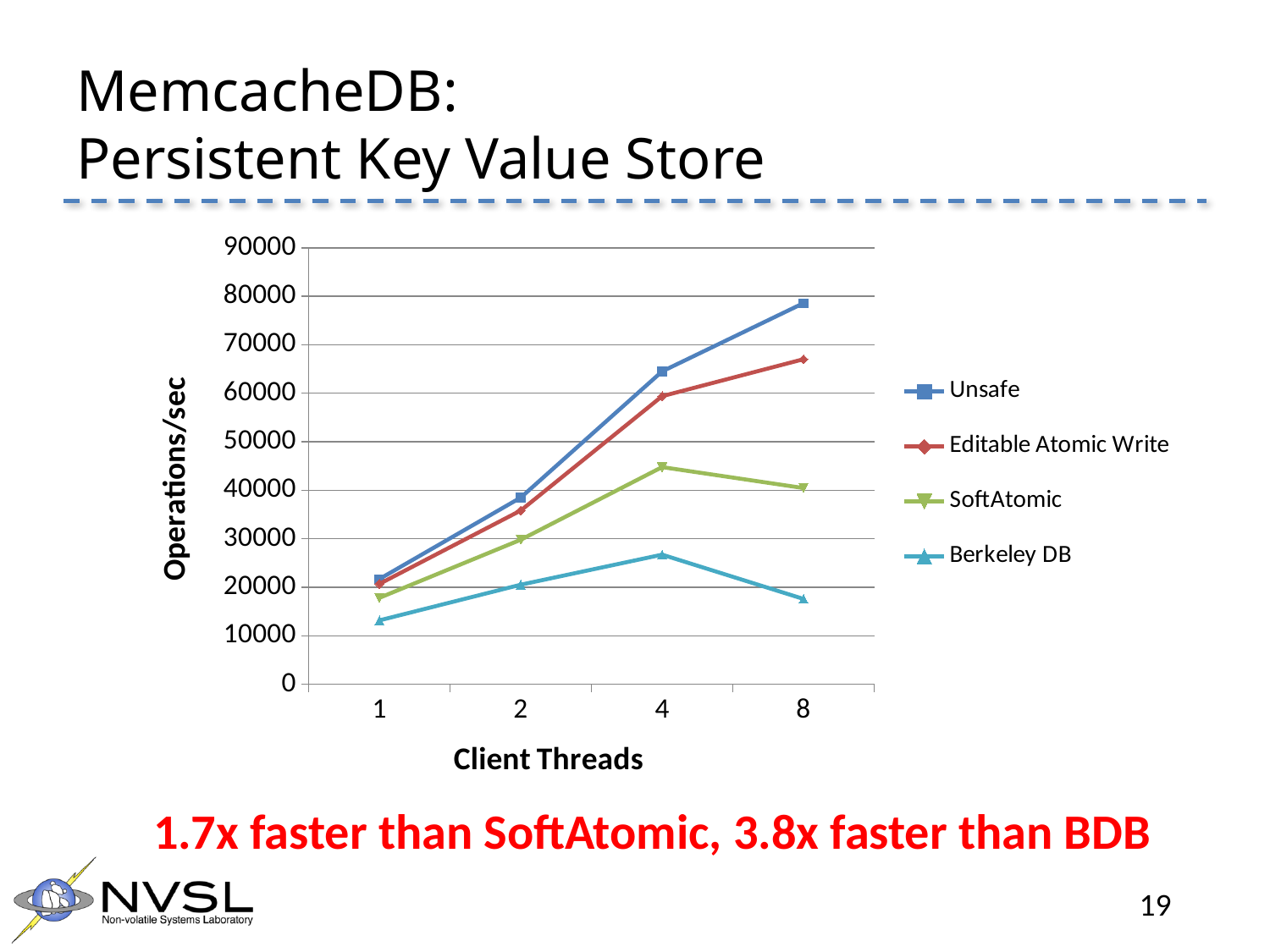
Is the value for SoftAtomic at 4 client threads greater or less than 40000? greater What is the title of the y axis? Operations/sec How many series does the legend list? 4 Which series has the highest value at 8 client threads? Unsafe Is the value for Unsafe at 8 client threads greater or less than 70000? greater Does the Berkeley DB series rise or fall from 4 to 8 client threads? fall What kind of chart is shown on the slide? line chart Which series has the lowest value at 8 client threads? Berkeley DB Does the Unsafe series rise or fall as client threads increase from 1 to 8? rise At 8 client threads, which is larger: SoftAtomic or Berkeley DB? SoftAtomic Is the value for Berkeley DB at 4 client threads greater or less than 30000? less How many client thread counts are plotted along the x axis? 4